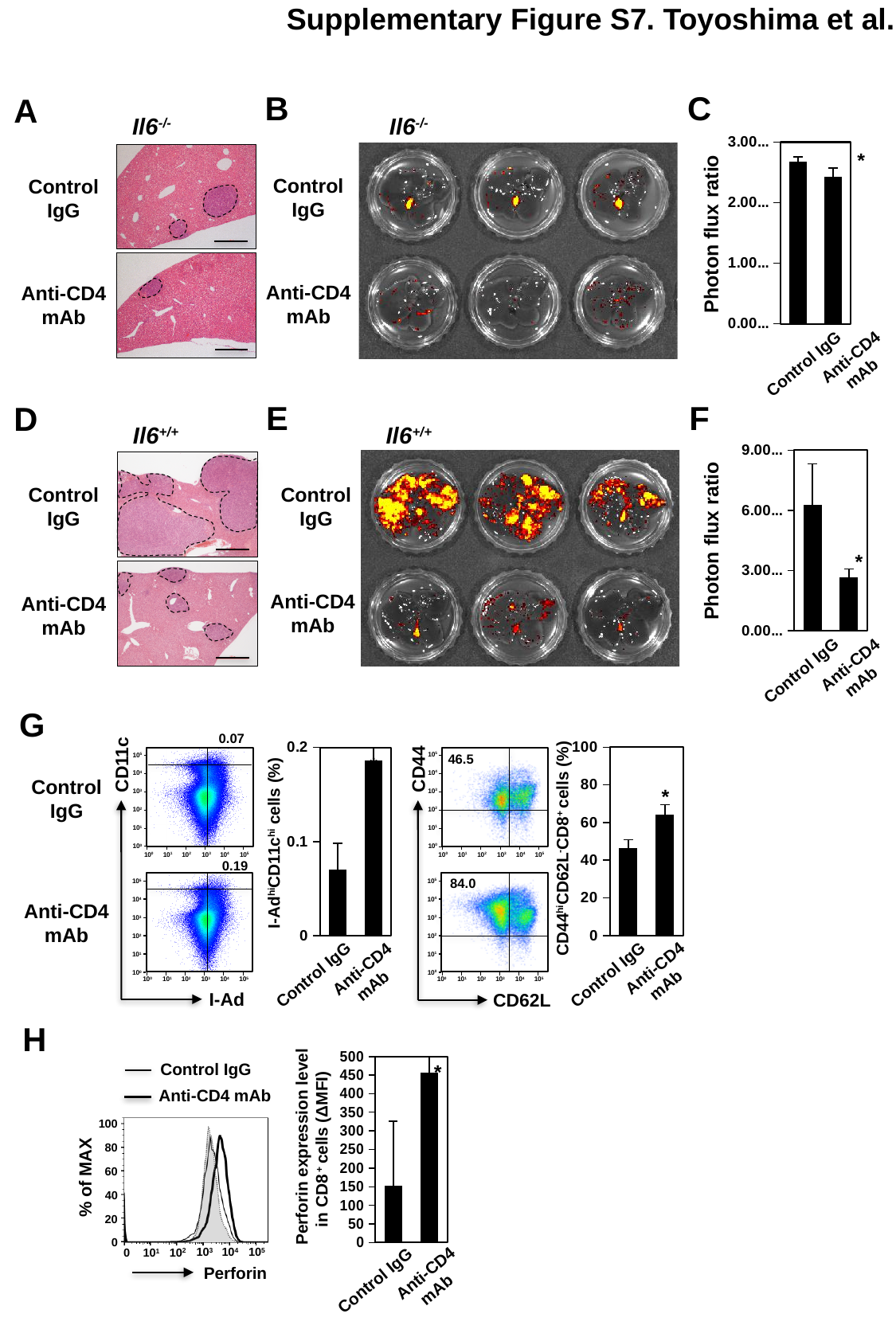
In panel C, is the photon flux ratio for Anti-CD4 mAb greater or less than 2.00? greater In panel G, what percentage is printed on the Anti-CD4 mAb CD44/CD62L dot plot? 84.0 In panel C, how many categories are plotted on the x axis? 2 In panel F, is the photon flux ratio for Anti-CD4 mAb greater or less than 3.00? less In panel F, is the photon flux ratio for Control IgG greater or less than 3.00? greater In the bar chart of panel H, what is the y-axis label? Perforin expression level in CD8+ cells (ΔMFI) In panel F, which category has the lowest photon flux ratio? Anti-CD4 mAb In panel C, what kind of chart is shown? bar chart In panel C, which category has the higher photon flux ratio, Control IgG or Anti-CD4 mAb? Control IgG